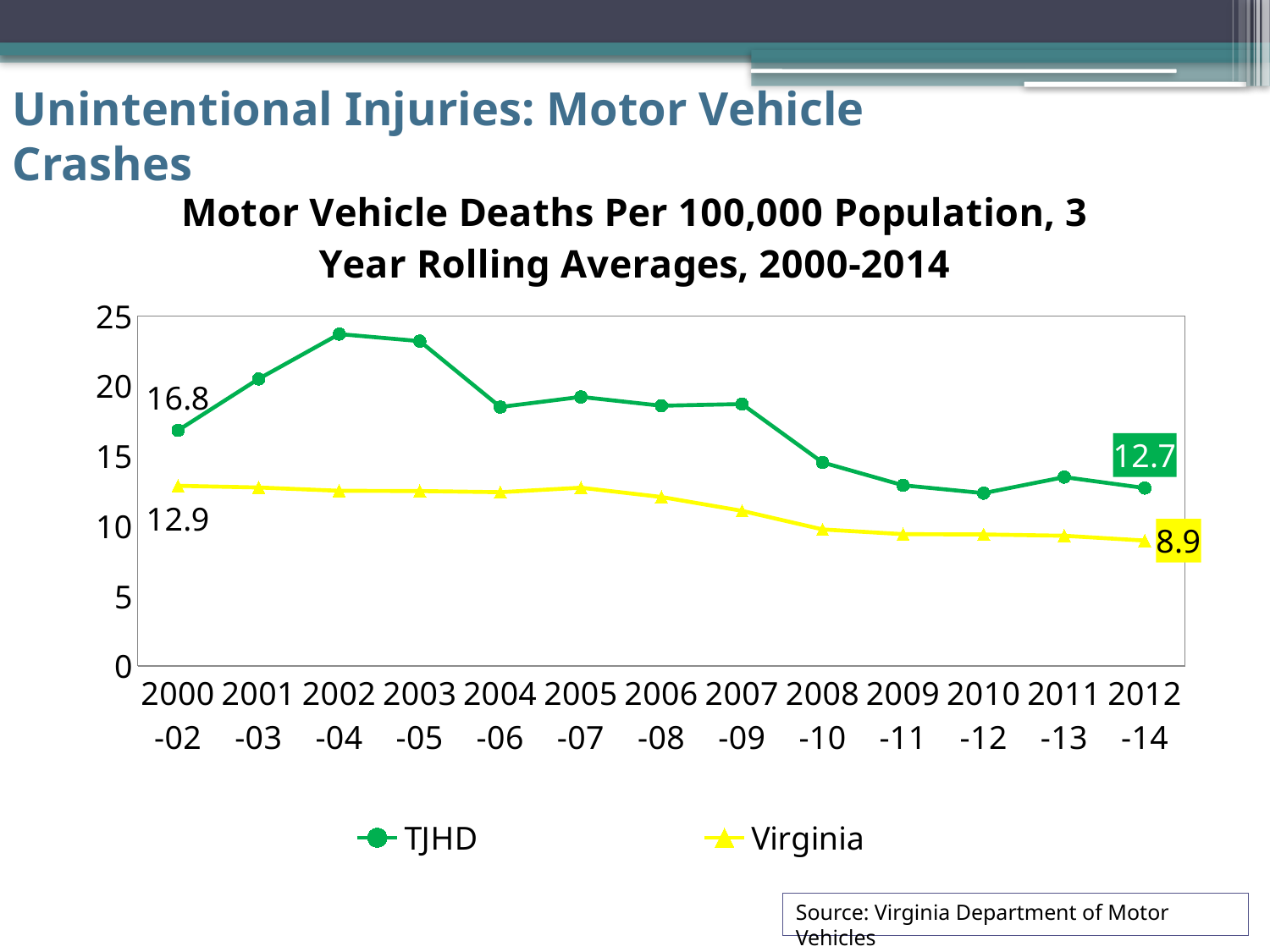
What is the Virginia value for 2000-02? 12.9 How many time periods are shown on the x axis? 13 By how much did the TJHD value fall from 2000-02 to 2012-14? 4.1 What is the difference between the TJHD and Virginia values in 2012-14? 3.8 Is the TJHD value for 2004-06 greater or less than 20? less How many series does the legend list? 2 What is the Virginia value for 2012-14? 8.9 What is the TJHD value for 2000-02? 16.8 What is the TJHD value for 2012-14? 12.7 Is the TJHD value for 2002-04 greater or less than 20? greater In 2000-02, which series has the higher value, TJHD or Virginia? TJHD What kind of chart is shown on the slide? Line chart